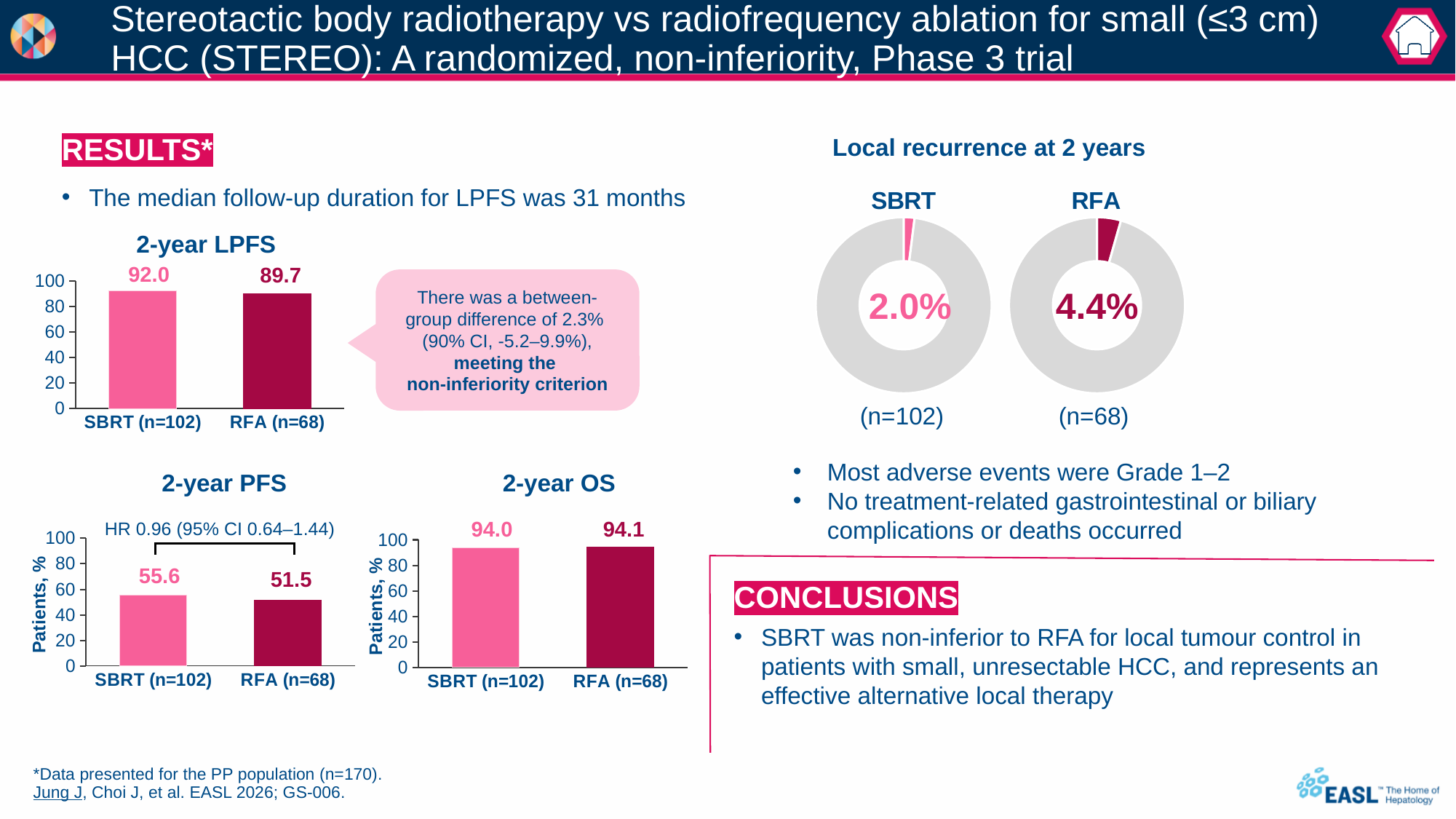
In the Local recurrence at 2 years chart, what is the value for RFA? 4.4% What kind of chart is the 2-year OS chart? Bar chart In the Local recurrence at 2 years chart, what is the value for SBRT? 2.0% In the 2-year LPFS chart, what is the value for RFA (n=68)? 89.7 How many bars are shown in the 2-year PFS chart? 2 In the 2-year OS chart, what is the value for RFA (n=68)? 94.1 In the 2-year PFS chart, what is the difference between the SBRT and RFA values? 4.1 In the 2-year LPFS chart, what is the value for SBRT (n=102)? 92.0 In the 2-year PFS chart, what is the value for SBRT (n=102)? 55.6 In the 2-year LPFS chart, what is the difference between the SBRT and RFA values? 2.3 In the 2-year PFS chart, which group has the higher value, SBRT or RFA? SBRT In the 2-year OS chart, what is the value for SBRT (n=102)? 94.0